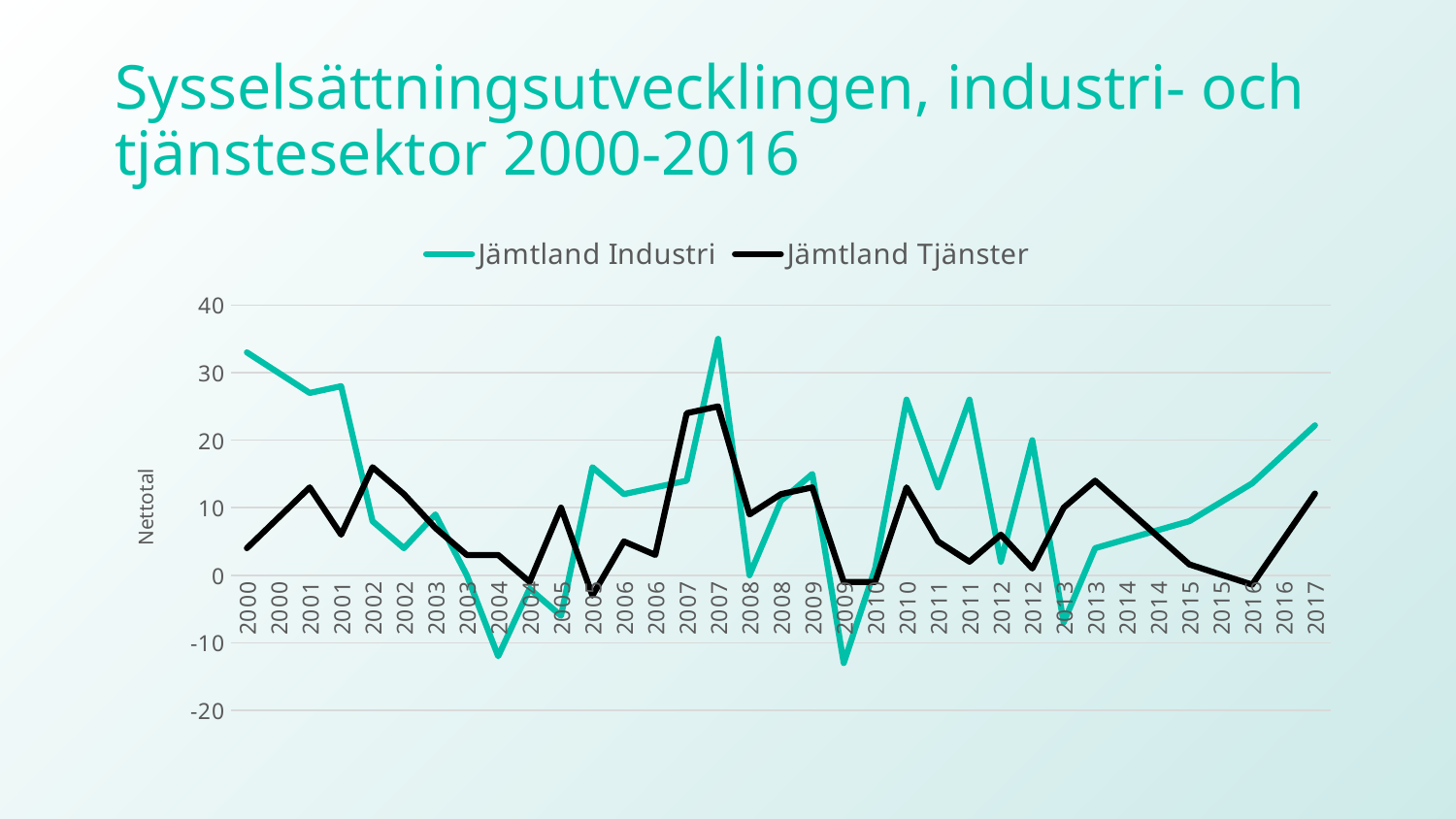
Which series reaches the highest value on the chart? Jämtland Industri Which series reaches the lowest value on the chart? Jämtland Industri At the first 2000 point, which series has the larger value, Jämtland Industri or Jämtland Tjänster? Jämtland Industri How many series does the legend list? 2 What is the title of the chart on the slide? Sysselsättningsutvecklingen, industri- och tjänstesektor 2000-2016 Is the lowest value for Jämtland Industri in 2009 greater or less than -10? less What type of chart is shown on the slide? Line chart At the first 2007 point, which series has the larger value, Jämtland Industri or Jämtland Tjänster? Jämtland Tjänster Does the Jämtland Industri line rise or fall from 2000 to 2002? Fall What is the label on the vertical axis? Nettotal Is the peak value for Jämtland Tjänster in 2007 greater or less than 20? greater Is the value for Jämtland Industri at the first 2000 point greater or less than 30? greater